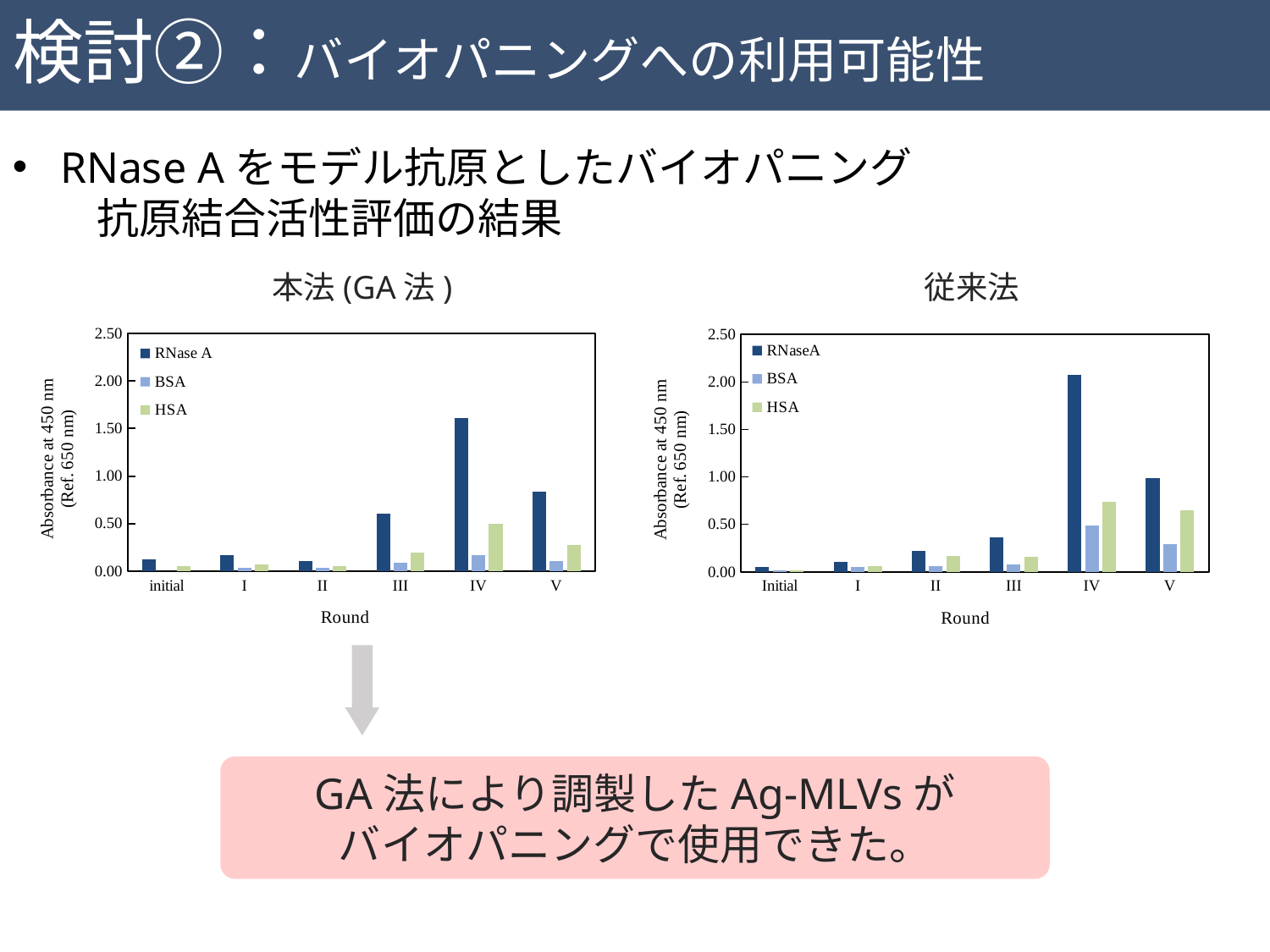
In the right chart (従来法), how many series does the legend list? 3 What is the x-axis title of the right chart (従来法)? Round In the right chart (従来法), is the RNase A value at round IV greater or less than 2.00? greater In the right chart (従来法), at which round is the RNase A bar highest? IV In the left chart (本法 (GA 法)), at which round is the RNase A bar highest? IV In the left chart (本法 (GA 法)), at round IV, which is larger: the RNase A bar or the HSA bar? RNase A What kind of chart is the left chart titled 本法 (GA 法)? bar chart In the left chart (本法 (GA 法)), how many rounds are shown on the x axis? 6 Which chart has the taller RNase A bar at round IV, the left chart (本法 (GA 法)) or the right chart (従来法)? 従来法 In the right chart (従来法), is the HSA value at round IV greater or less than 0.50? greater In the left chart (本法 (GA 法)), is the RNase A value at round V greater or less than 0.50? greater